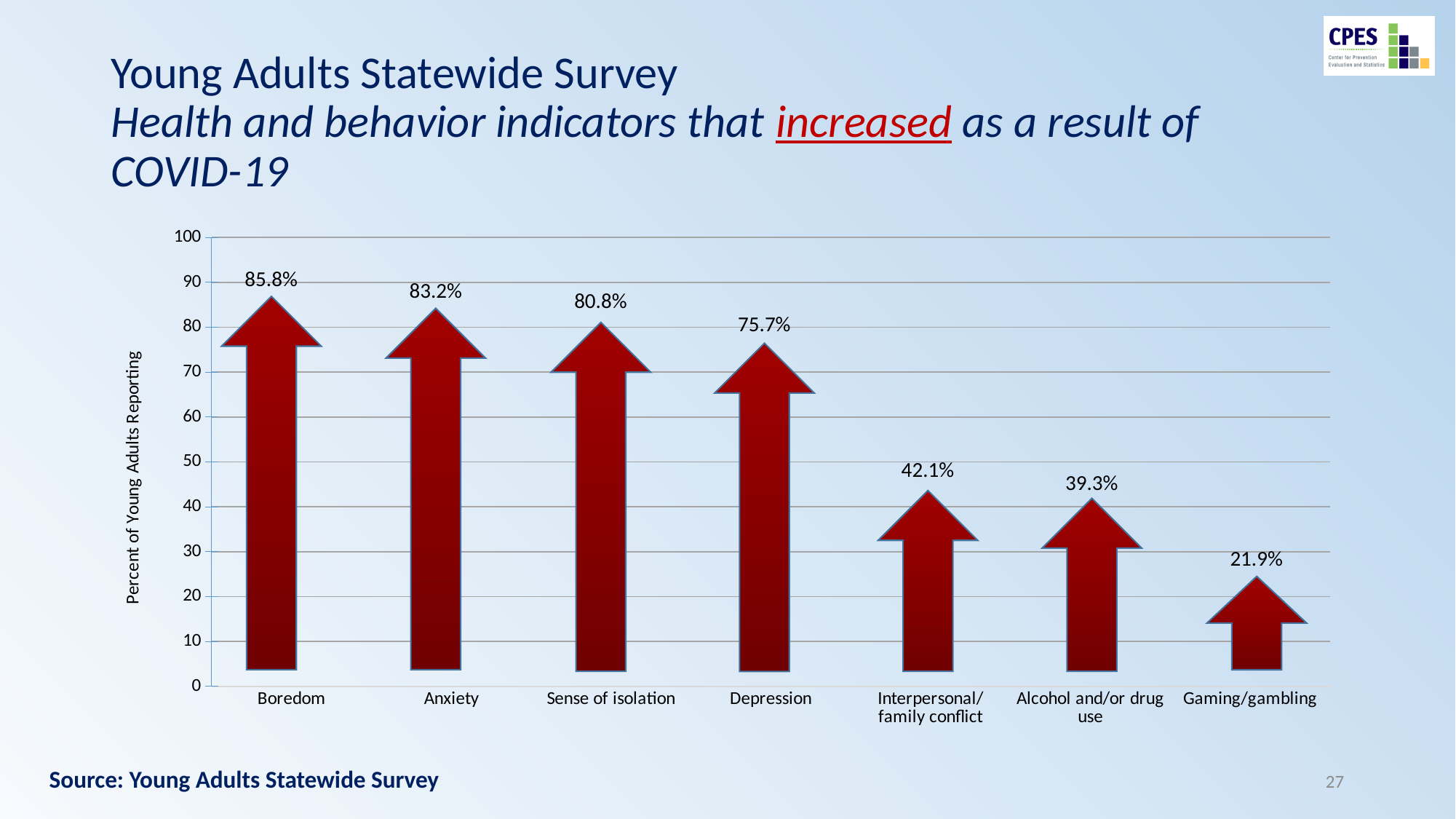
What is the difference between the values for Interpersonal/family conflict and Gaming/gambling? 20.2% What percent of young adults reported an increase in Alcohol and/or drug use? 39.3% What percent of young adults reported that Boredom increased as a result of COVID-19? 85.8% What is the label on the vertical axis of the chart? Percent of Young Adults Reporting Which indicator has the highest percent of young adults reporting an increase? Boredom Is the value for Sense of isolation greater or less than 70? greater Which is larger, the value for Depression or the value for Interpersonal/family conflict? Depression Which indicator has the lowest percent of young adults reporting an increase? Gaming/gambling How many indicators are shown on the chart? 7 What is the difference between the values for Anxiety and Sense of isolation? 2.4% Do the values rise or fall moving from left to right across the x axis? fall What is the value shown for Depression? 75.7%